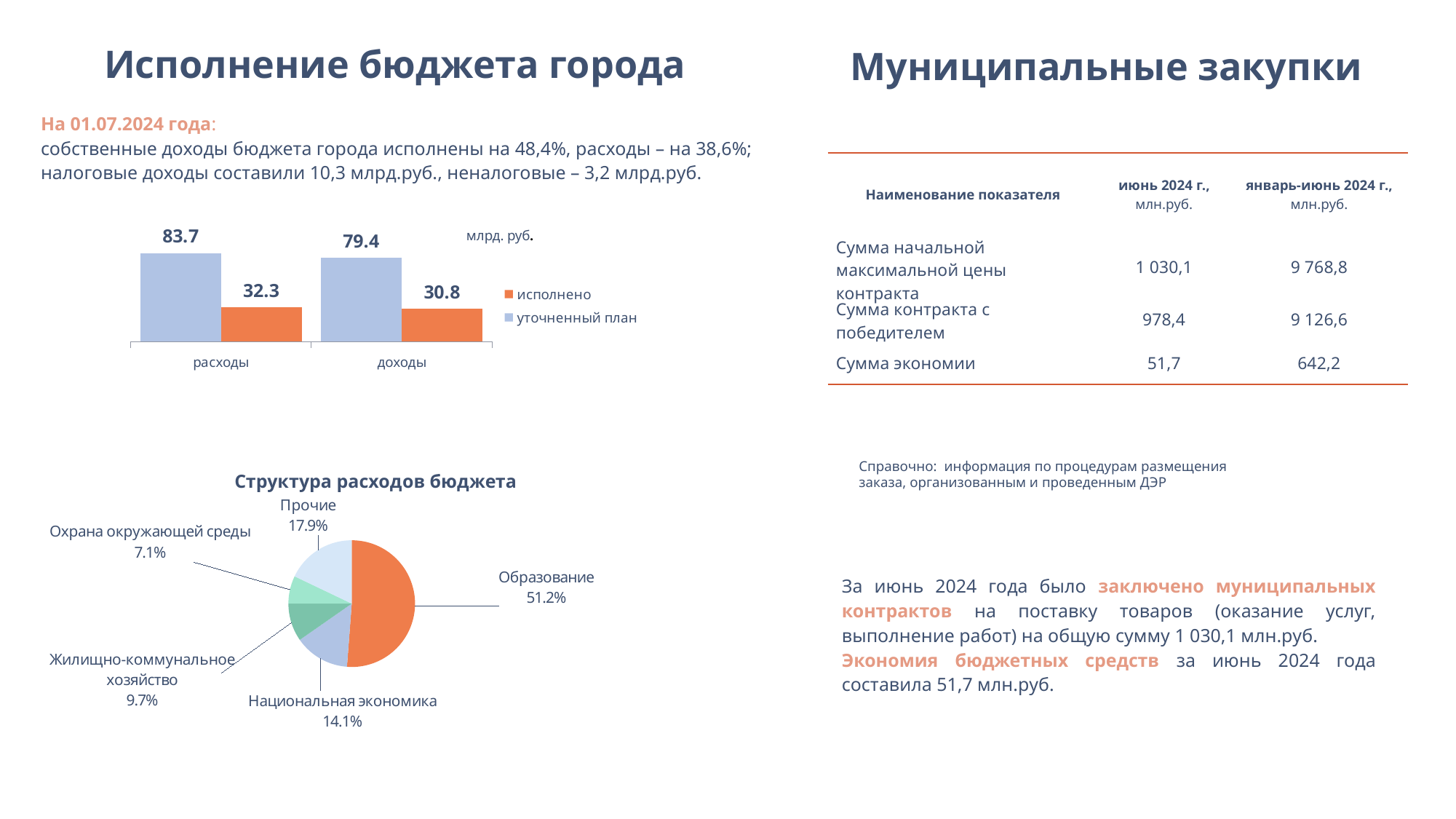
How many categories are shown in the chart 'Структура расходов бюджета'? 5 In the bar chart at the top left of the slide, which is larger: 'уточненный план' for 'расходы' or 'уточненный план' for 'доходы'? расходы How many series does the legend of the bar chart at the top left of the slide list? 2 In the bar chart at the top left of the slide, what is the value of 'исполнено' for 'доходы'? 30.8 In the bar chart at the top left of the slide, what is the value of 'уточненный план' for 'расходы'? 83.7 What kind of chart is the chart at the top left of the slide showing 'расходы' and 'доходы'? bar chart In the bar chart at the top left of the slide, what is the difference between 'уточненный план' and 'исполнено' for 'расходы'? 51.4 In the chart 'Структура расходов бюджета', what share does 'Образование' have? 51.2% In the chart 'Структура расходов бюджета', which category has the largest share? Образование In the chart 'Структура расходов бюджета', what is the difference between the shares of 'Прочие' and 'Национальная экономика'? 3.8% In the chart 'Структура расходов бюджета', which category has the smallest share? Охрана окружающей среды In the bar chart at the top left of the slide, what unit is indicated next to the chart? млрд. руб.